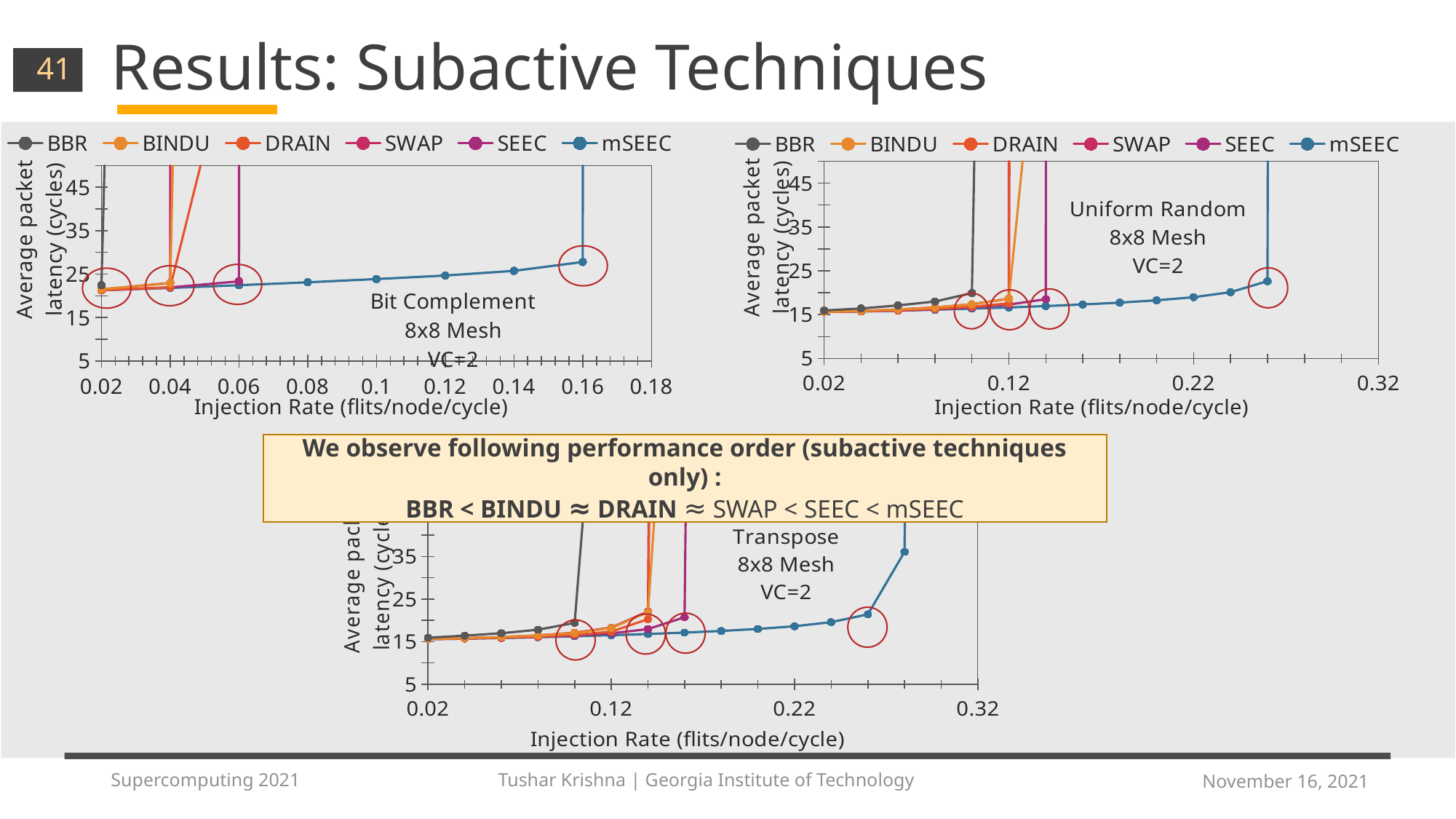
In the Uniform Random chart, is the mSEEC latency at injection rate 0.22 greater or less than 25? less In the Transpose chart, does the mSEEC latency rise or fall as the injection rate increases? rises In the Bit Complement chart, which series has its latency spike at the lowest injection rate? BBR Which series are listed in the legend of the Bit Complement chart? BBR, BINDU, DRAIN, SWAP, SEEC, mSEEC In the Uniform Random chart, which series reaches the highest injection rate before its latency spikes? mSEEC In the Bit Complement chart, which series reaches the highest injection rate before its latency spikes? mSEEC In the Transpose chart, which series has its latency spike at the lowest injection rate? BBR How many series does the legend of the Uniform Random chart list? 6 What is the largest injection rate tick shown on the x axis of the Uniform Random chart? 0.32 What kind of chart is the Bit Complement chart? line chart In the Transpose chart, is the mSEEC latency at injection rate 0.02 greater or less than 25? less In the Bit Complement chart, is the mSEEC latency at injection rate 0.14 greater or less than 35? less